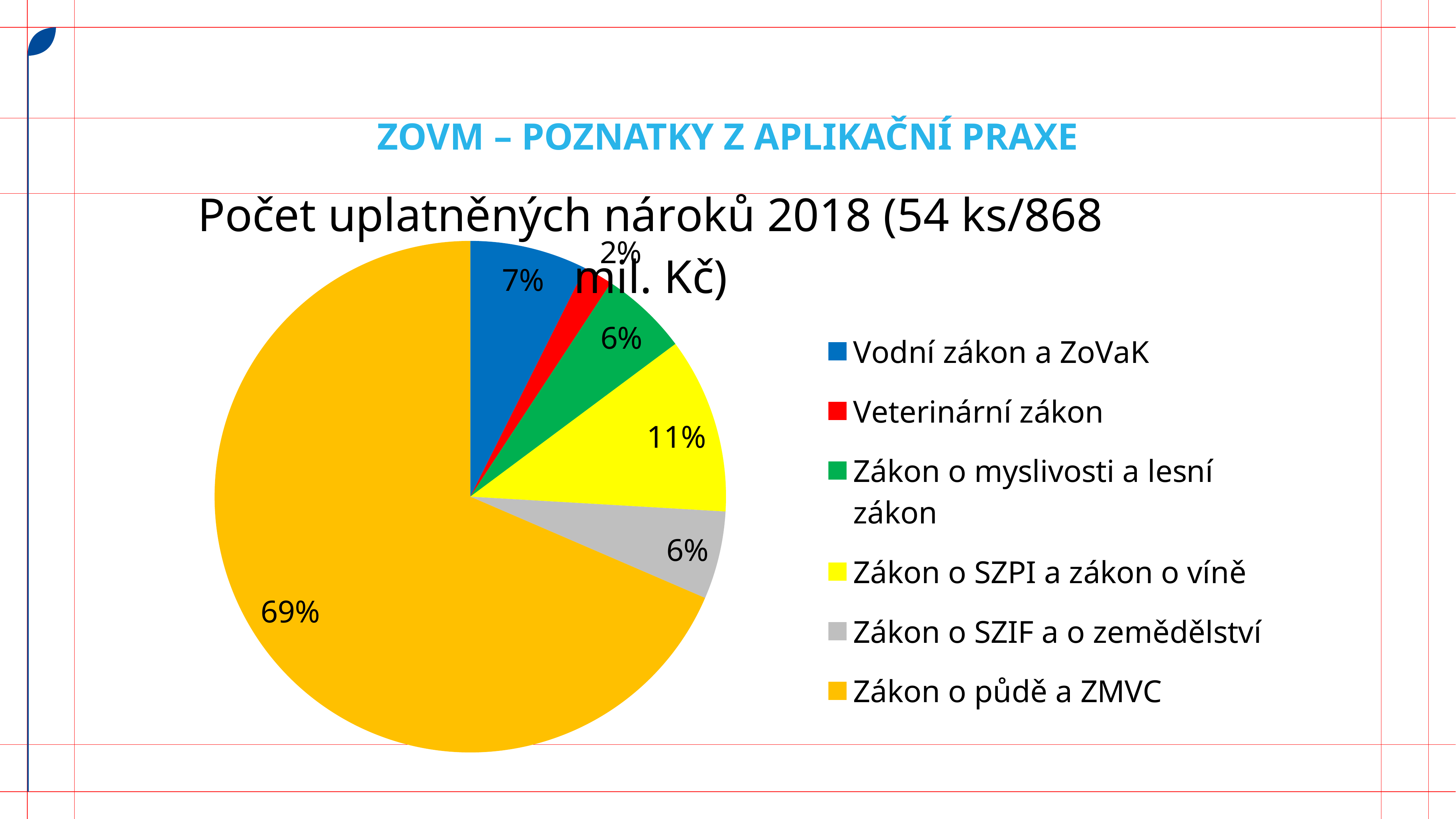
What share of the pie does Zákon o SZPI a zákon o víně represent? 11% Which is larger, the share for Vodní zákon a ZoVaK or the share for Zákon o myslivosti a lesní zákon? Vodní zákon a ZoVaK How many categories does the pie chart have? 6 What share of the pie does Veterinární zákon represent? 2% What share of the pie does Zákon o půdě a ZMVC represent? 69% What is the difference in percentage points between Zákon o SZPI a zákon o víně and Vodní zákon a ZoVaK? 4 percentage points Which category has the smallest slice of the pie? Veterinární zákon What type of chart is shown on the slide? Pie chart Which category has the largest slice of the pie? Zákon o půdě a ZMVC What is the title of the pie chart? Počet uplatněných nároků 2018 (54 ks/868 mil. Kč)